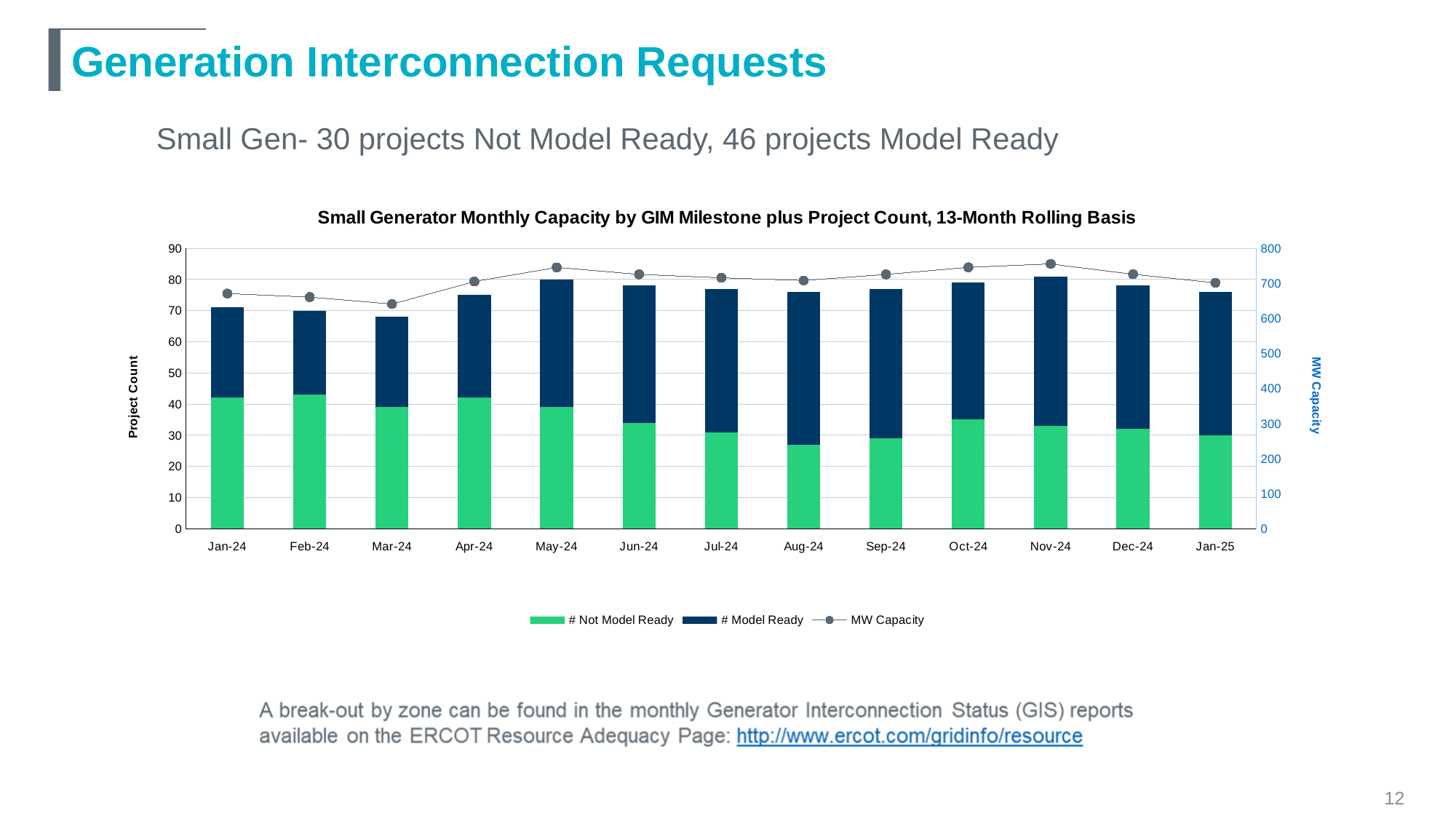
What kind of chart is shown on the slide? Stacked bar chart with a line Which month has the lowest MW Capacity? Mar-24 Is the MW Capacity value for Mar-24 greater or less than 700? less Which is larger, the # Not Model Ready value for Jan-24 or for Aug-24? Jan-24 How many months are shown on the x axis of the chart? 13 How many Small Gen projects are Not Model Ready in Jan-25? 30 How many Small Gen projects are Model Ready in Jan-25? 46 Does the # Not Model Ready value rise or fall from Jan-24 to Aug-24? Fall What is the total project count for the Jan-25 bar (Not Model Ready plus Model Ready)? 76 Is the # Not Model Ready value for Aug-24 greater or less than 30? less Is the MW Capacity value for Nov-24 greater or less than 700? greater How many series does the chart legend list? 3